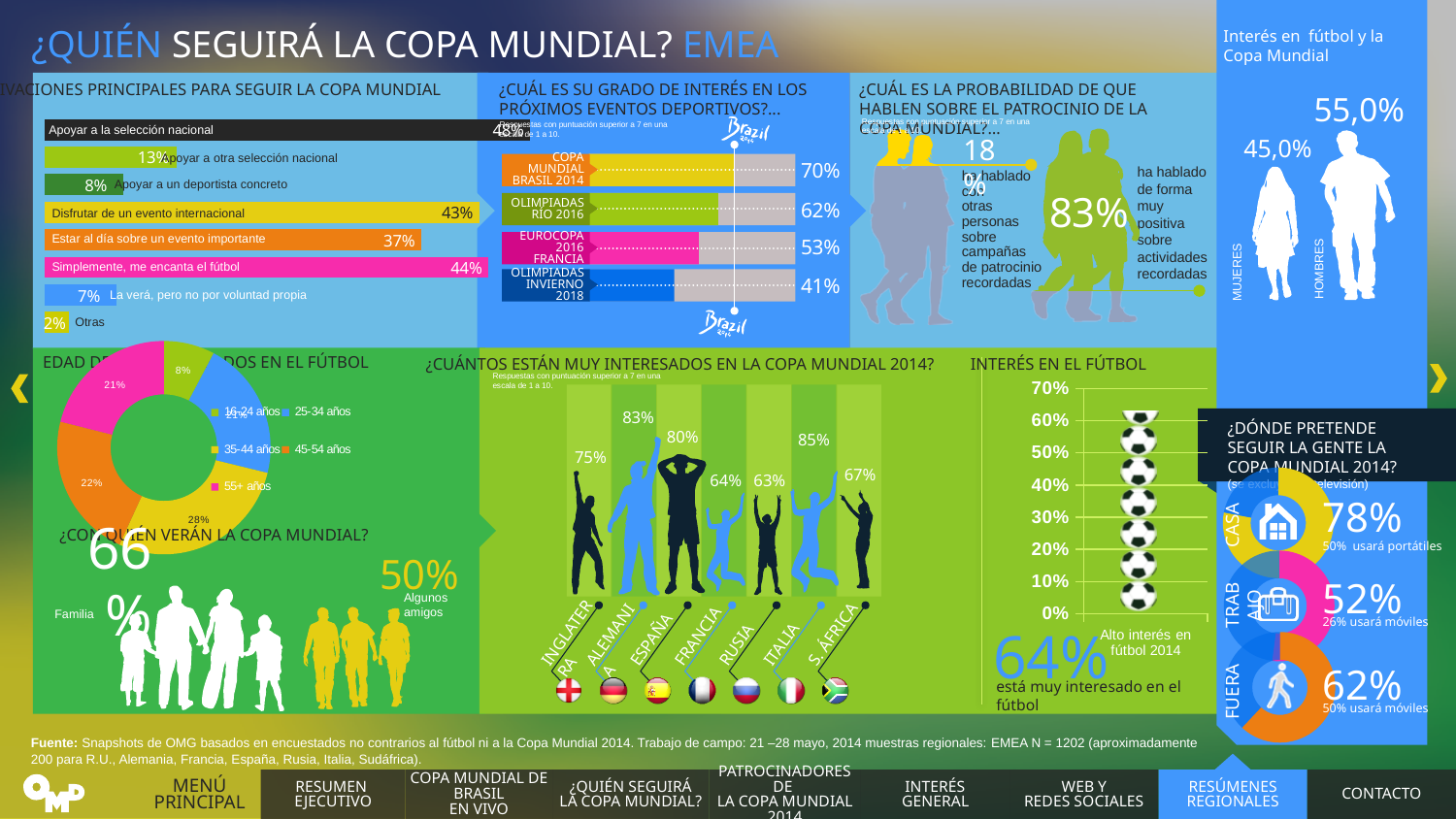
In the chart '¿Cuántos están muy interesados en la Copa Mundial 2014?', which is larger, Inglaterra or Francia? Inglaterra In the chart '¿Dónde pretende seguir la gente la Copa Mundial 2014?', which location has the highest value? Casa In the chart '¿Cuántos están muy interesados en la Copa Mundial 2014?', what is the value for Alemania? 83% In the chart '¿Cuál es su grado de interés en los próximos eventos deportivos?', what is the difference between Olimpiadas Río 2016 and Eurocopa 2016 Francia? 9% In the chart 'Interés en fútbol y la Copa Mundial', what is the value for Hombres? 55,0% In the chart '¿Cuántos están muy interesados en la Copa Mundial 2014?', how many countries are shown? 7 In the chart '¿Cuál es su grado de interés en los próximos eventos deportivos?', which event has the lowest value? Olimpiadas Invierno 2018 In the chart '¿Cuál es su grado de interés en los próximos eventos deportivos?', what is the value for Copa Mundial Brasil 2014? 70% In the chart 'Motivaciones principales para seguir la Copa Mundial', what is the value for 'Disfrutar de un evento internacional'? 43% What kind of chart is '¿Cuántos están muy interesados en la Copa Mundial 2014?'? Pictogram (human figure icons with percentage labels) In the chart 'Motivaciones principales para seguir la Copa Mundial', what is the difference between 'Simplemente, me encanta el fútbol' and 'Estar al día sobre un evento importante'? 7% In the chart '¿Cuántos están muy interesados en la Copa Mundial 2014?', which country has the highest value? Italia